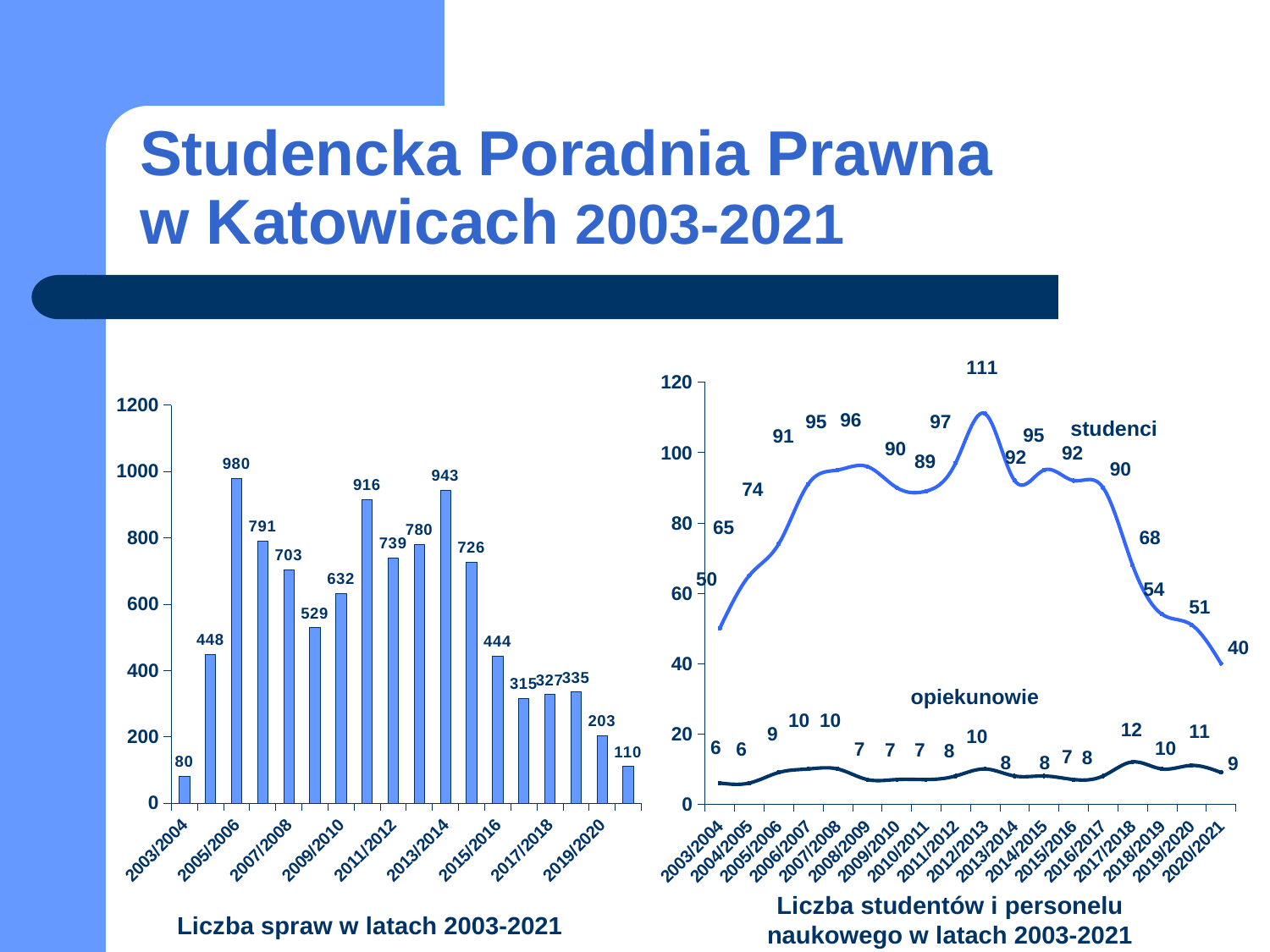
In the chart 'Liczba studentów i personelu naukowego w latach 2003-2021', does the studenci line rise or fall from 2016/2017 to 2020/2021? fall How many series are plotted in the chart 'Liczba studentów i personelu naukowego w latach 2003-2021'? 2 In the chart 'Liczba spraw w latach 2003-2021', what is the difference between the values for 2013/2014 and 2015/2016? 499 In the chart 'Liczba spraw w latach 2003-2021', which year has the highest number of cases? 2005/2006 In the chart 'Liczba spraw w latach 2003-2021', which year has the lowest value? 2003/2004 In the chart 'Liczba spraw w latach 2003-2021', which is larger: the value for 2011/2012 or the value for 2009/2010? 2011/2012 In the chart 'Liczba studentów i personelu naukowego w latach 2003-2021', what is the value for studenci in 2012/2013? 111 In the chart 'Liczba studentów i personelu naukowego w latach 2003-2021', in which year is the studenci value lowest? 2020/2021 How many bars are plotted in the chart 'Liczba spraw w latach 2003-2021'? 18 In the chart 'Liczba spraw w latach 2003-2021', what is the value for 2005/2006? 980 What kind of chart is 'Liczba spraw w latach 2003-2021'? bar chart In the chart 'Liczba studentów i personelu naukowego w latach 2003-2021', what is the value for opiekunowie in 2020/2021? 9